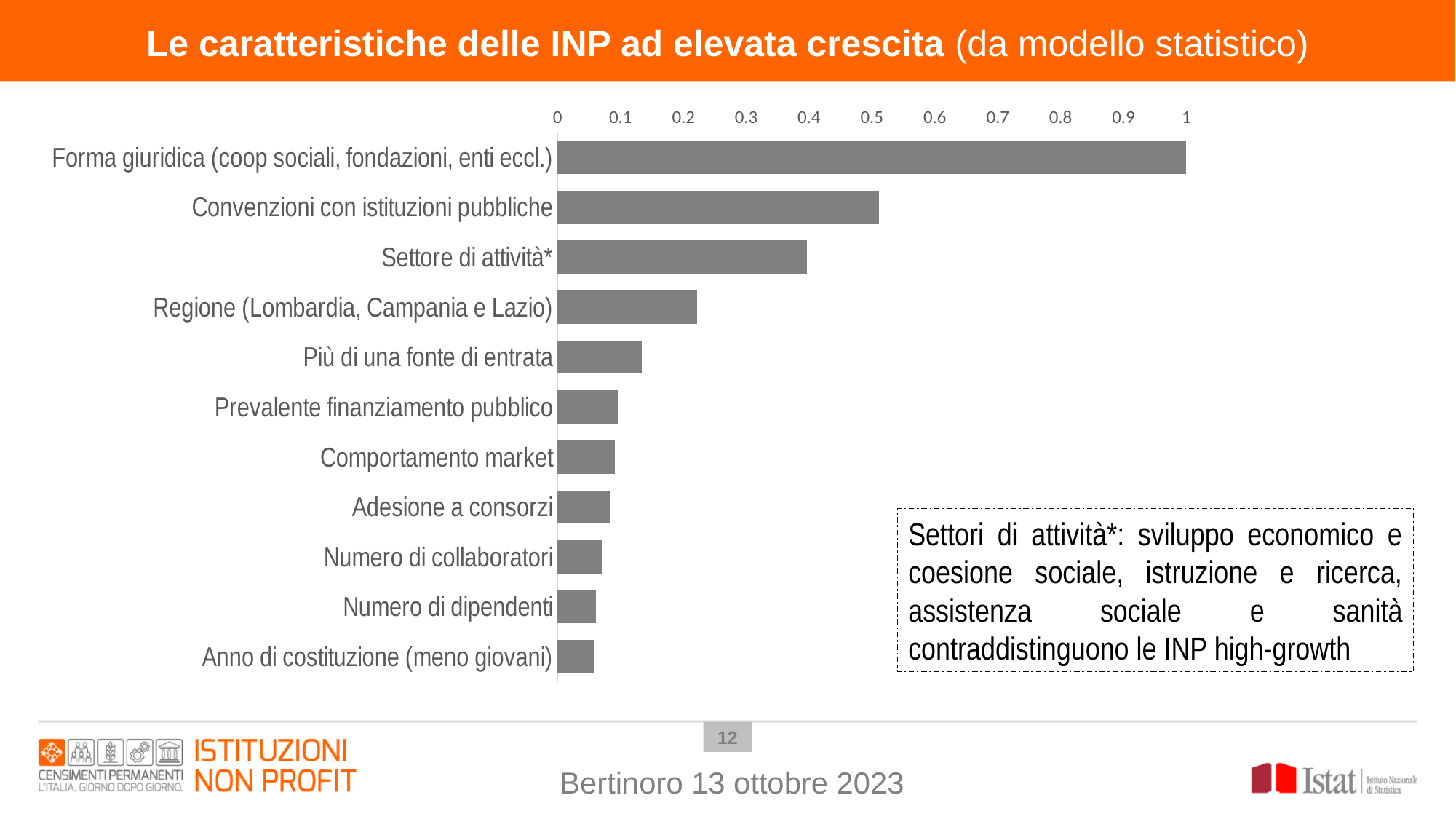
What is the value for Forma giuridica (coop sociali, fondazioni, enti eccl.)? 1 Which category has the highest value in the chart? Forma giuridica (coop sociali, fondazioni, enti eccl.) Is the value for Convenzioni con istituzioni pubbliche greater or less than 0.4? greater What is the title of the slide containing the chart? Le caratteristiche delle INP ad elevata crescita (da modello statistico) Do the bar values increase or decrease going from the top category to the bottom category? Decrease How many categories are plotted in the chart? 11 Is the value for Più di una fonte di entrata greater or less than 0.2? less Is the value for Numero di dipendenti greater or less than 0.1? less Which has a larger value: Convenzioni con istituzioni pubbliche or Regione (Lombardia, Campania e Lazio)? Convenzioni con istituzioni pubbliche What kind of chart is shown on the slide? Bar chart